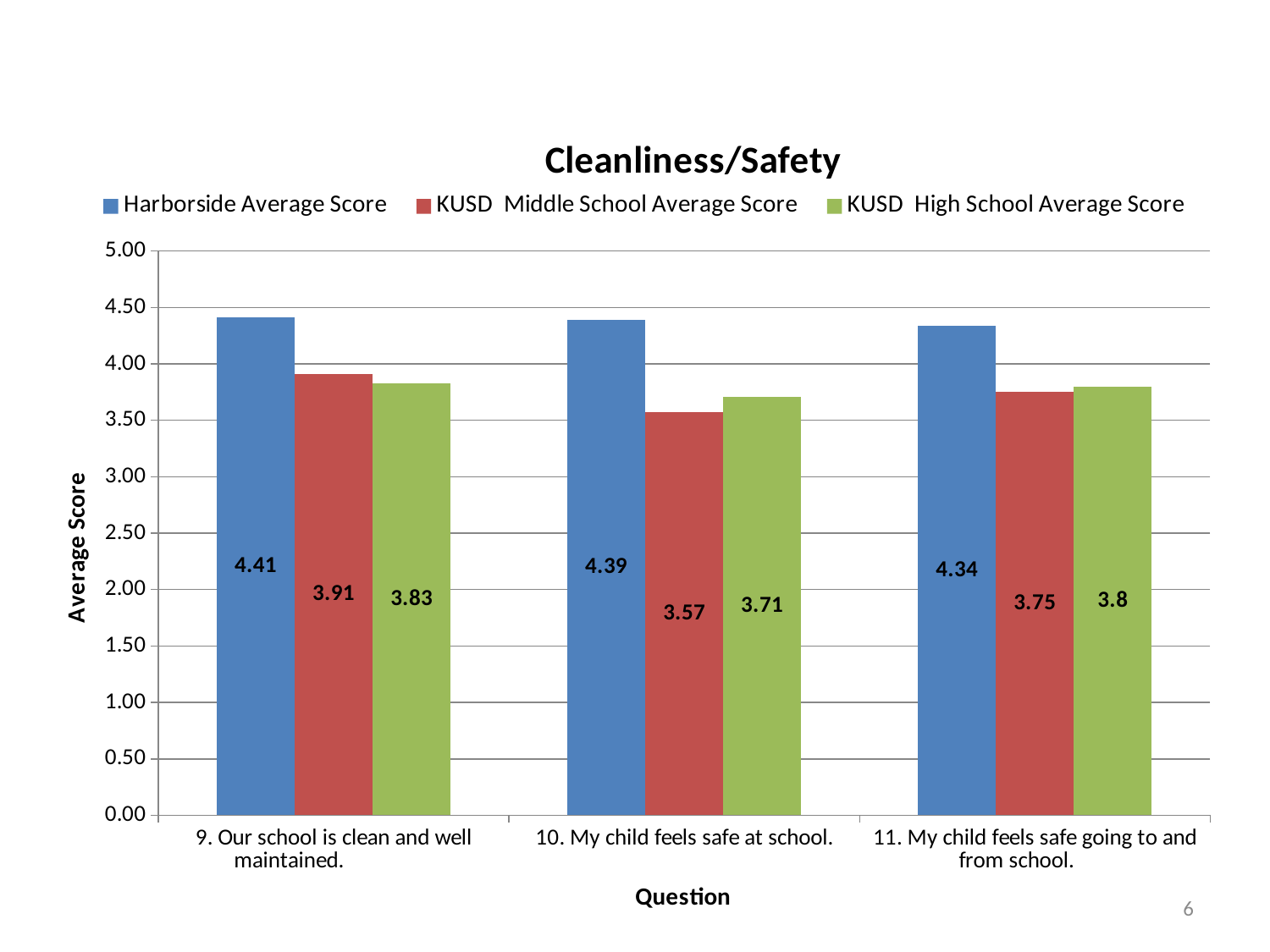
Which question has the highest Harborside Average Score? 9. Our school is clean and well maintained. Is the Harborside Average Score for question 11 greater or less than 4.00? greater How many questions are shown on the x axis of the chart? 3 What is the title of the chart? Cleanliness/Safety What kind of chart is shown on the slide? Bar chart Which question has the lowest KUSD Middle School Average Score? 10. My child feels safe at school. What is the difference between the Harborside Average Score and the KUSD Middle School Average Score for question 10? 0.82 What is the KUSD Middle School Average Score for question 10, "My child feels safe at school"? 3.57 What is the KUSD High School Average Score for question 11, "My child feels safe going to and from school"? 3.8 How many series does the legend list? 3 What is the Harborside Average Score for question 9, "Our school is clean and well maintained"? 4.41 For question 11, which is larger: the KUSD Middle School Average Score or the KUSD High School Average Score? KUSD High School Average Score